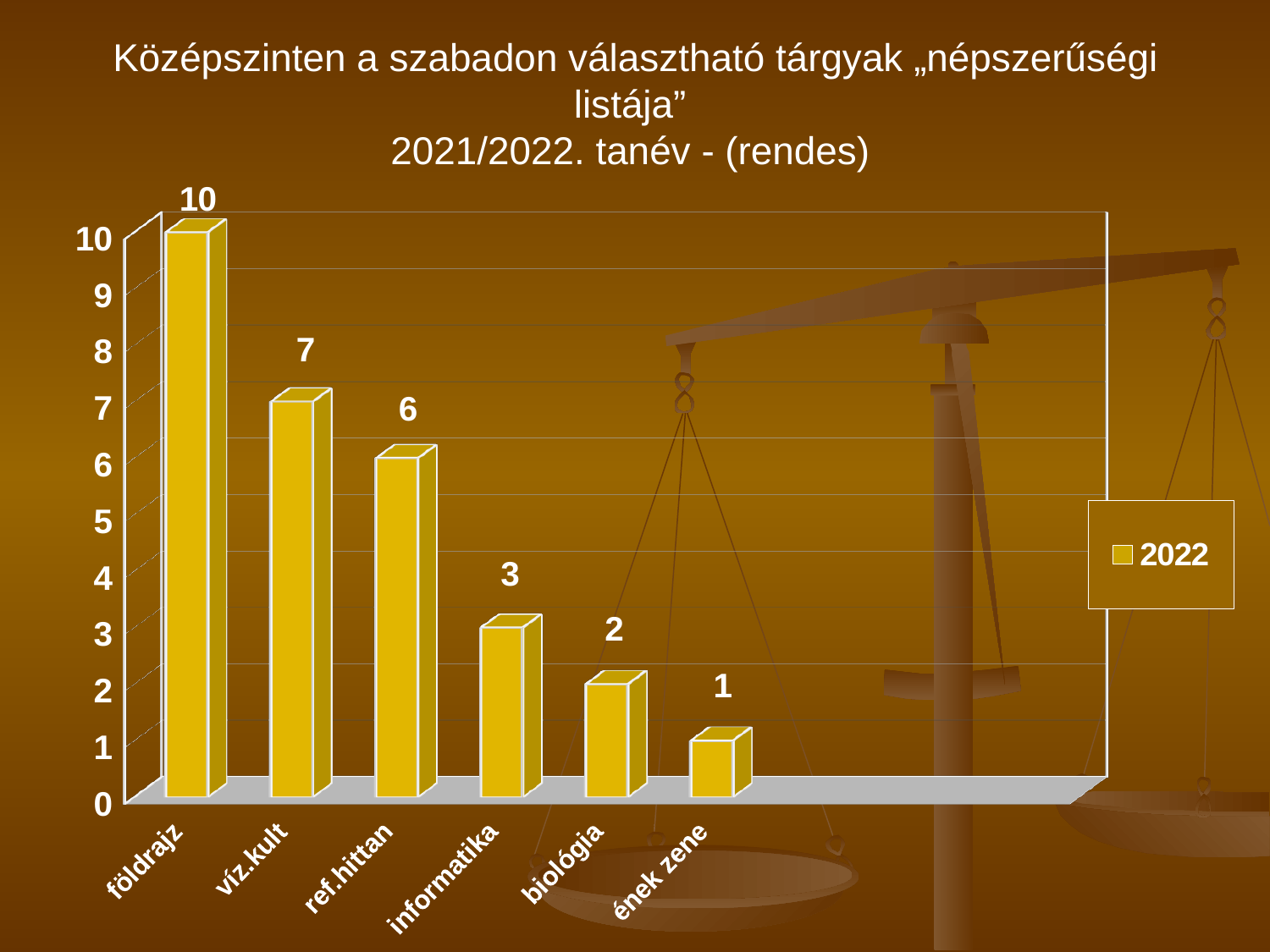
Which is larger, the value for biológia or the value for informatika? informatika What is the difference between the values for földrajz and víz.kult? 3 What is the value for földrajz? 10 What is the value for víz.kult? 7 What is the value for ref.hittan? 6 What series does the legend list? 2022 Which category has the highest value? földrajz What is the value for informatika? 3 Which category has the lowest value? ének zene What kind of chart is shown on the slide? bar chart What is the value for ének zene? 1 How many categories are shown on the x axis? 6